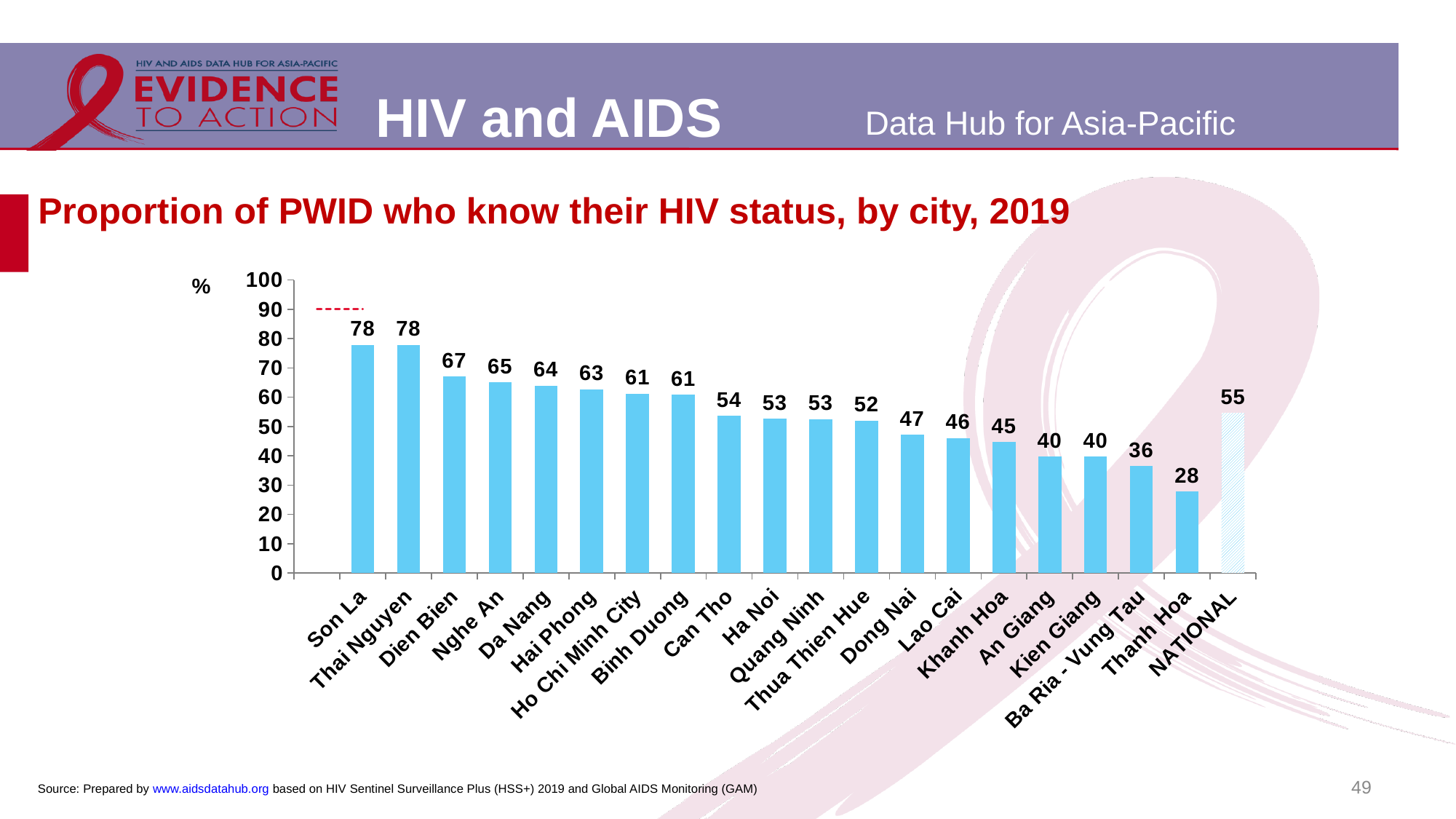
Which city has the lowest proportion of PWID who know their HIV status? Thanh Hoa What is the value for Dien Bien? 67 What kind of chart is shown on the slide? Bar chart How many bars are plotted on the chart? 20 What unit is shown on the y axis of the chart? % What is the difference between the values for Dien Bien and Nghe An? 2 What is the NATIONAL value shown on the chart? 55 Which is larger, the value for Can Tho or the value for Ha Noi? Can Tho Do the city values rise or fall from left to right across the chart (before the NATIONAL bar)? Fall What is the value for Ba Ria - Vung Tau? 36 What is the value for Ho Chi Minh City? 61 What is the difference between the values for Son La and Thanh Hoa? 50